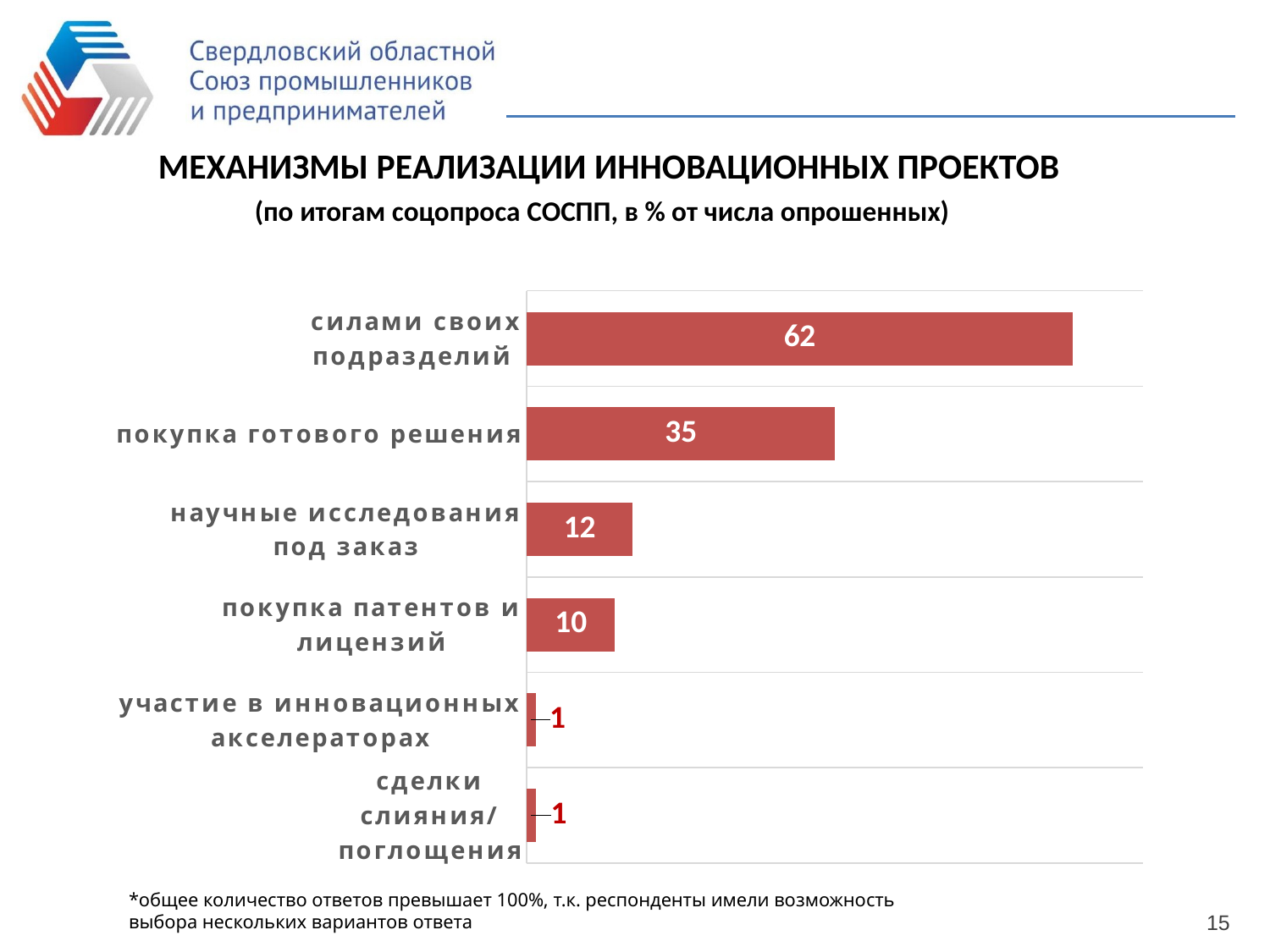
What is the title of the chart on the slide? МЕХАНИЗМЫ РЕАЛИЗАЦИИ ИННОВАЦИОННЫХ ПРОЕКТОВ What is the value for «покупка патентов и лицензий»? 10 What is the value for «научные исследования под заказ»? 12 Which is larger, the value for «покупка готового решения» or the value for «научные исследования под заказ»? покупка готового решения How many categories are shown in the chart? 6 What is the difference between the values for «научные исследования под заказ» and «покупка патентов и лицензий»? 2 What kind of chart is shown on the slide? bar chart What is the difference between the values for «силами своих подразделий» and «покупка готового решения»? 27 What is the value for «покупка готового решения»? 35 What is the value for «участие в инновационных акселераторах»? 1 What is the value for «силами своих подразделий»? 62 Which category has the highest value? силами своих подразделий